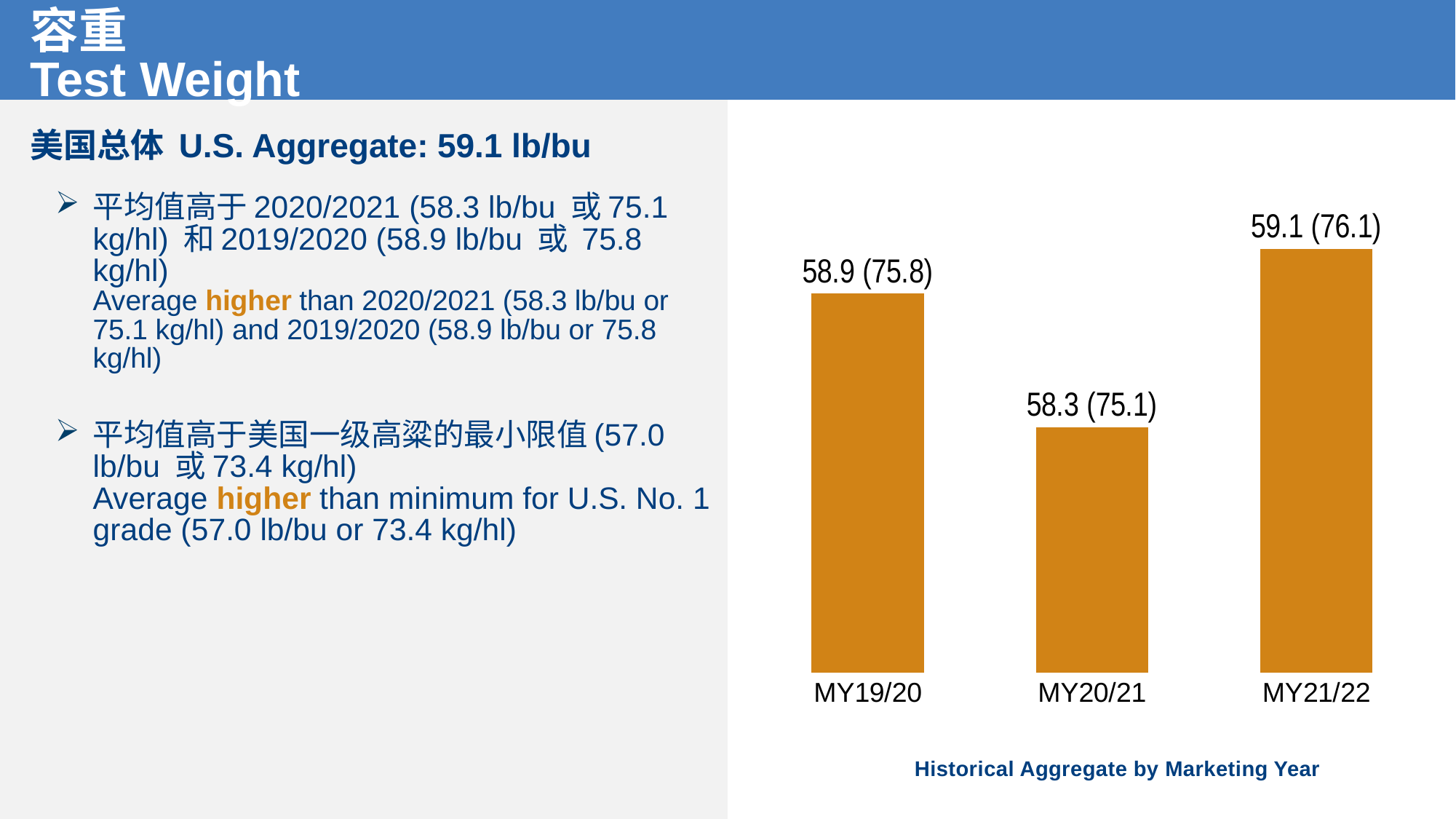
What is the difference in lb/bu between MY19/20 and MY20/21? 0.6 Which is larger, the value for MY19/20 or MY21/22? MY21/22 Does the value fall or rise from MY20/21 to MY21/22? Rise Which marketing year has the lowest test weight? MY20/21 Which marketing year has the highest test weight? MY21/22 How many marketing years are shown in the chart? 3 What is the data label shown for MY21/22? 59.1 (76.1) What is the caption below the chart? Historical Aggregate by Marketing Year What is the data label shown for MY19/20? 58.9 (75.8) What is the data label shown for MY20/21? 58.3 (75.1) What is the difference in lb/bu between MY21/22 and MY20/21? 0.8 What kind of chart is shown on the slide? Bar chart